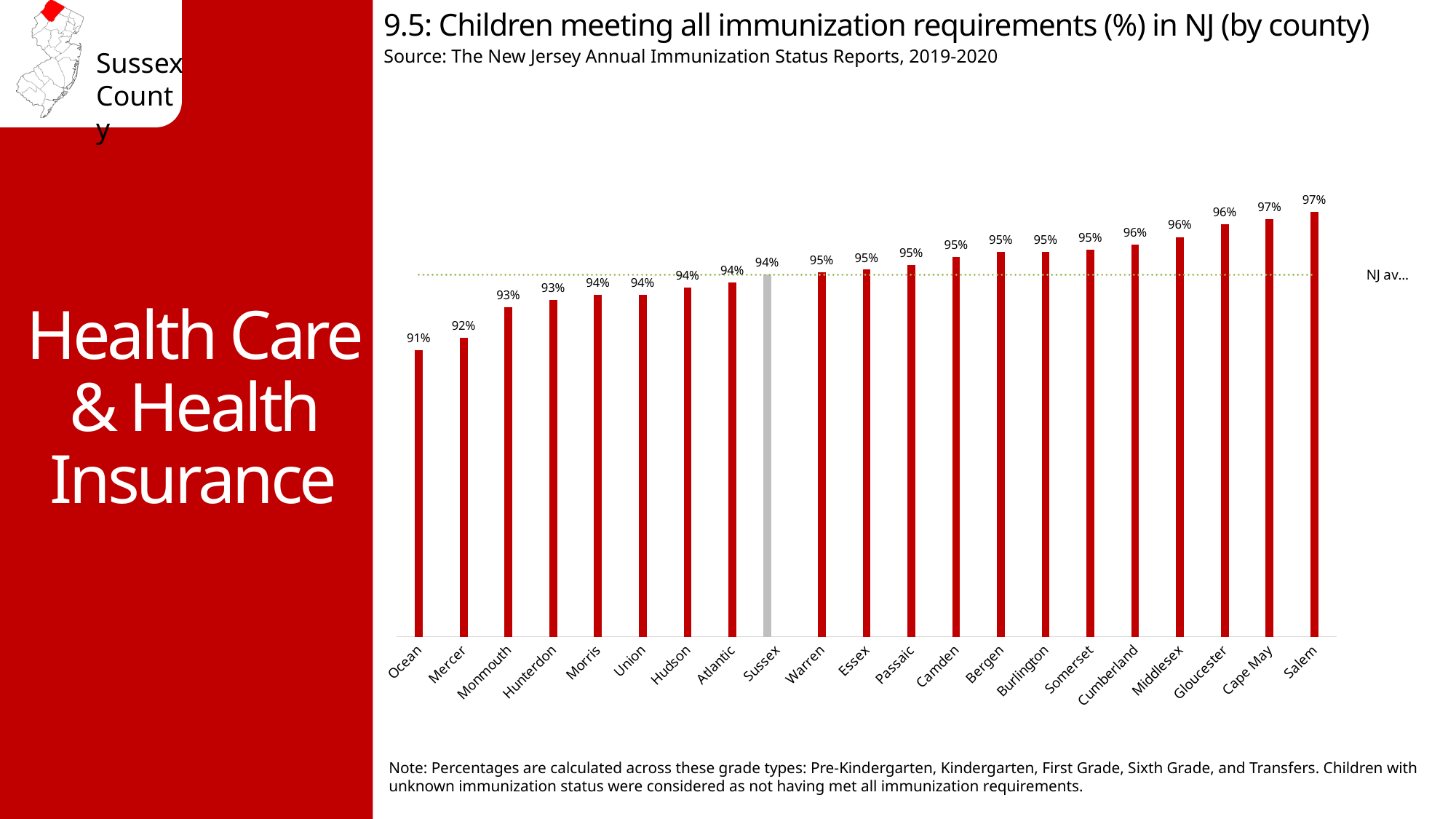
How many counties are shown on the chart? 21 What is the difference in percentage points between Mercer and Ocean? 1 percentage point What is the value shown for Ocean County? 91% Which county has the lowest percentage of children meeting all immunization requirements? Ocean Which county's bar is coloured grey instead of red? Sussex What kind of chart is this? Bar chart What is the difference in percentage points between Salem and Ocean? 6 percentage points Do the values generally rise or fall from left to right across the counties? Rise What percentage of children in Sussex County met all immunization requirements? 94% What is the value shown for Cumberland? 96% What is the value shown for Cape May? 97% Which has a higher value, Monmouth or Gloucester? Gloucester